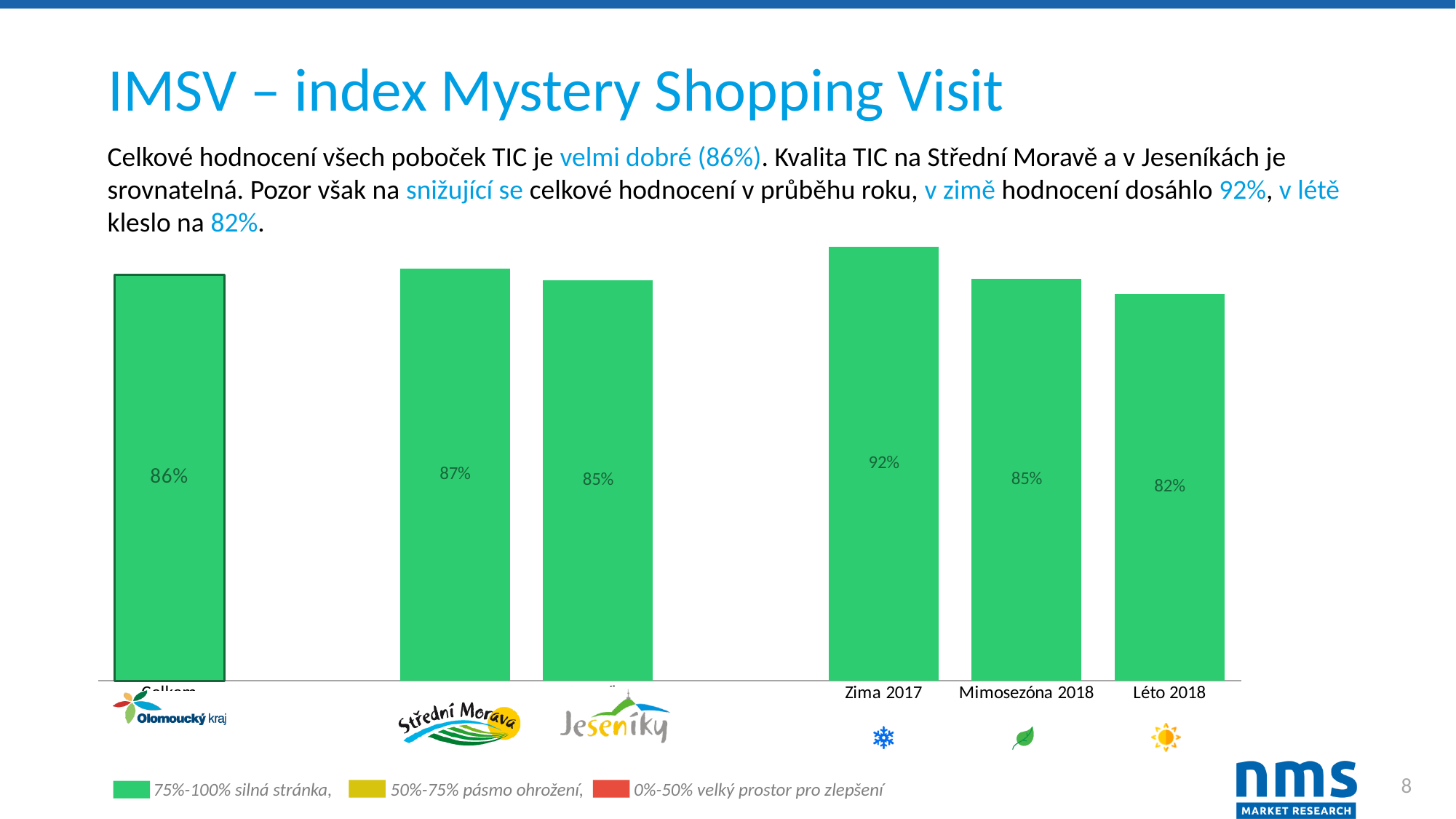
What is the value for Léto 2018? 82% What is the value for Mimosezóna 2018? 85% What is the value for Jeseníky? 85% What is the value for Zima 2017? 92% Which category has the lowest value? Léto 2018 What kind of chart is shown on the slide? Bar chart What is the value for Střední Morava? 87% Do the values fall or rise from Zima 2017 through Mimosezóna 2018 to Léto 2018? Fall Which category has the highest value? Zima 2017 What is the difference between the values for Zima 2017 and Léto 2018? 10% Which is larger, the value for Střední Morava or the value for Jeseníky? Střední Morava How many bars are plotted in the chart? 6